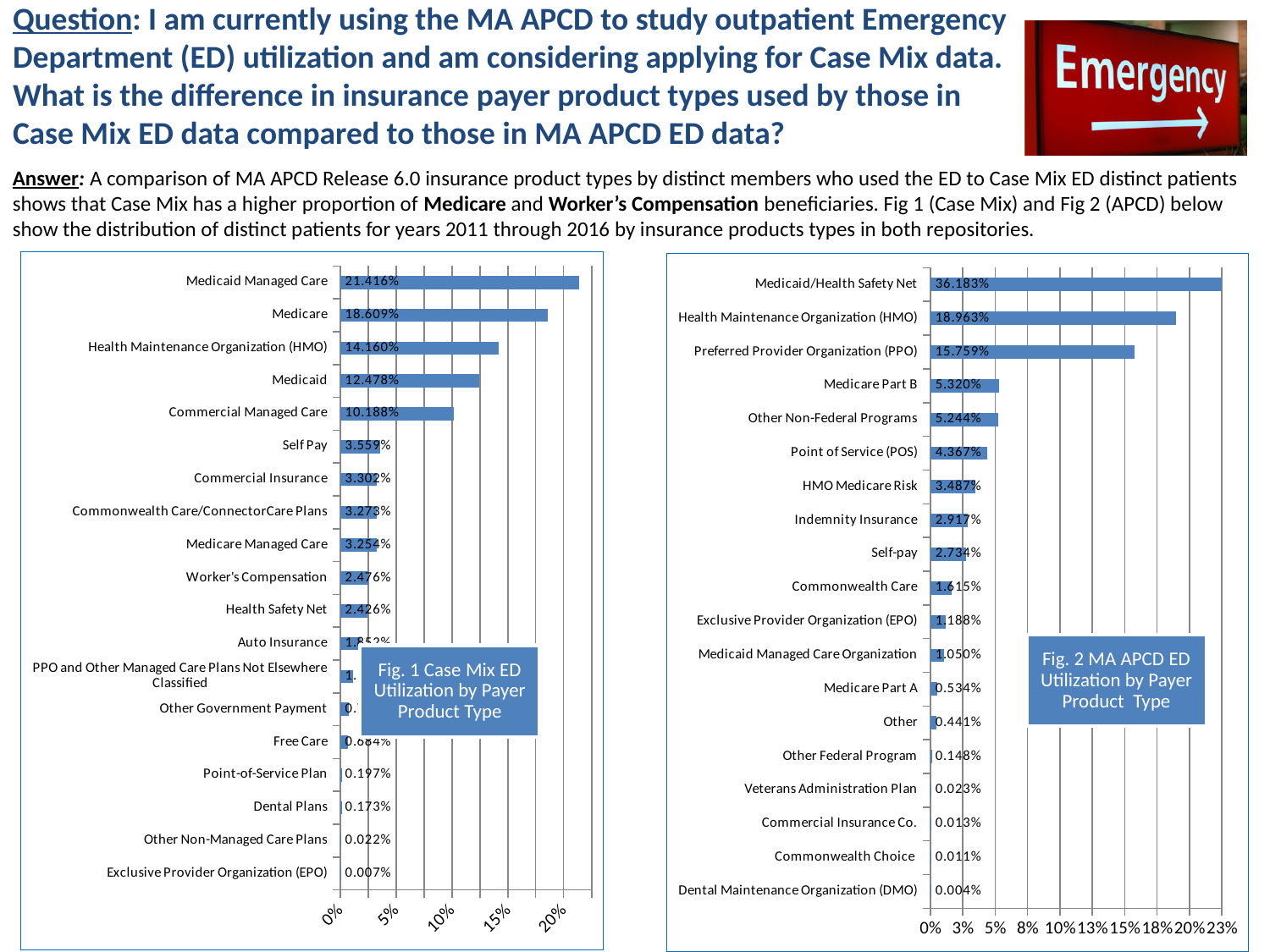
In the Fig. 2 MA APCD ED Utilization by Payer Product Type chart, which payer product type has the lowest value? Dental Maintenance Organization (DMO) In the Fig. 1 Case Mix ED Utilization by Payer Product Type chart, is the value for Commercial Managed Care greater or less than 10%? greater In the Fig. 1 Case Mix ED Utilization by Payer Product Type chart, what is the value for Worker's Compensation? 2.476% In the Fig. 2 MA APCD ED Utilization by Payer Product Type chart, what is the difference between Health Maintenance Organization (HMO) and Preferred Provider Organization (PPO)? 3.204% In the Fig. 1 Case Mix ED Utilization by Payer Product Type chart, which payer product type has the lowest value? Exclusive Provider Organization (EPO) In the Fig. 2 MA APCD ED Utilization by Payer Product Type chart, which is larger: Medicare Part B or Medicare Part A? Medicare Part B In the Fig. 1 Case Mix ED Utilization by Payer Product Type chart, what is the value for Medicare? 18.609% In the Fig. 2 MA APCD ED Utilization by Payer Product Type chart, what is the value for Medicaid/Health Safety Net? 36.183% In the Fig. 1 Case Mix ED Utilization by Payer Product Type chart, what is the difference between Medicaid Managed Care and Medicare? 2.807% What type of chart is the Fig. 1 Case Mix ED Utilization by Payer Product Type chart? Bar chart In the Fig. 1 Case Mix ED Utilization by Payer Product Type chart, which payer product type has the highest value? Medicaid Managed Care How many payer product types are shown in the Fig. 2 MA APCD ED Utilization by Payer Product Type chart? 19